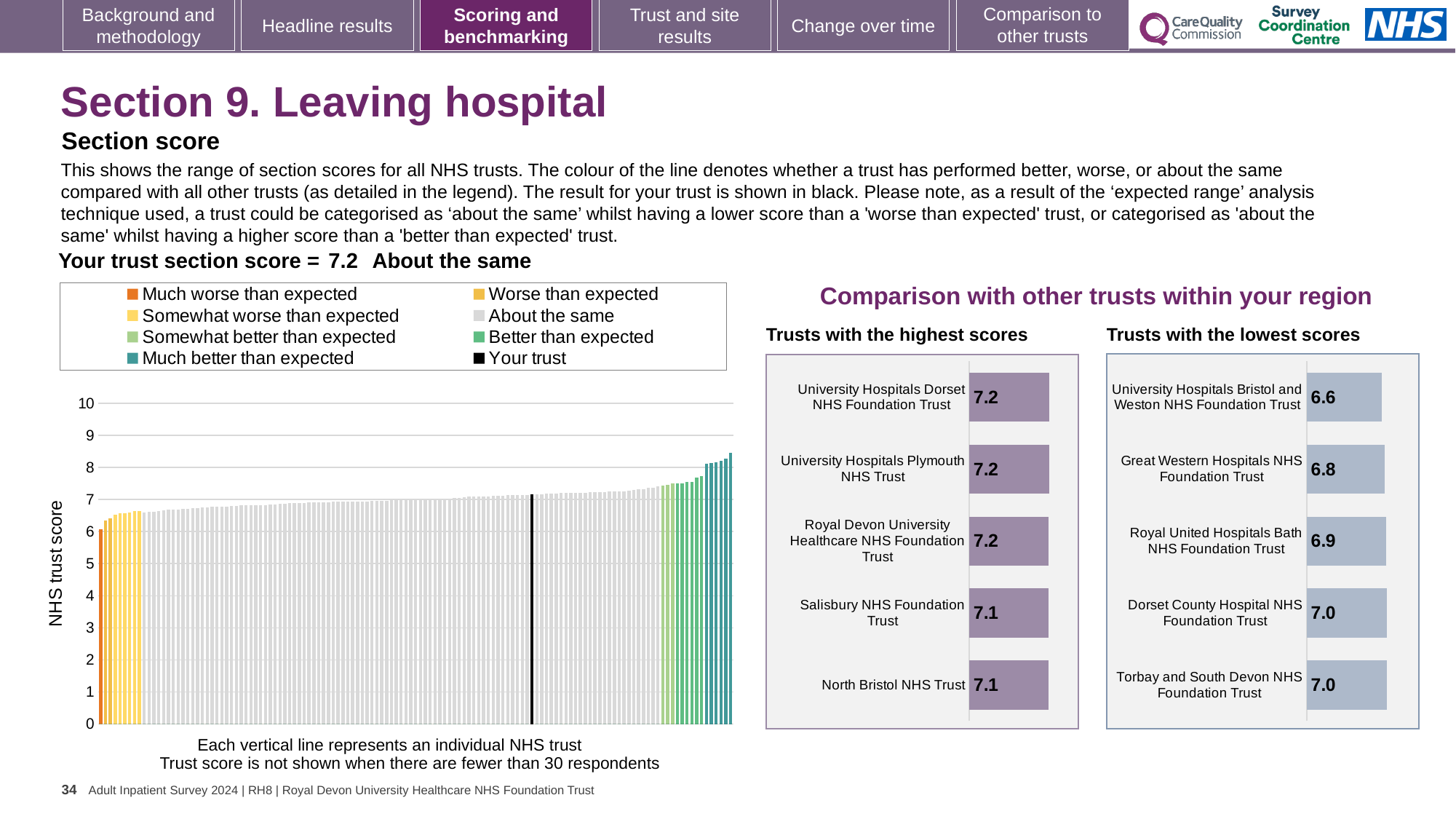
How many trusts are shown in the 'Trusts with the lowest scores' chart? 5 In the 'Trusts with the lowest scores' chart, what is the difference between the scores of Royal United Hospitals Bath NHS Foundation Trust and University Hospitals Bristol and Weston NHS Foundation Trust? 0.3 What is the section score for your trust shown on the slide? 7.2 In the 'Trusts with the lowest scores' chart, which has the higher score: Dorset County Hospital NHS Foundation Trust or Great Western Hospitals NHS Foundation Trust? Dorset County Hospital NHS Foundation Trust How many entries does the legend of the main section score chart list? 8 In the main section score chart, is the value for the lowest-scoring trust greater or less than 5? greater What type of chart is the 'Trusts with the highest scores' chart? Bar chart In the 'Trusts with the lowest scores' chart, what is the score for Great Western Hospitals NHS Foundation Trust? 6.8 In the 'Trusts with the lowest scores' chart, which trust has the lowest score? University Hospitals Bristol and Weston NHS Foundation Trust How many trusts are shown in the 'Trusts with the highest scores' chart? 5 In the 'Trusts with the highest scores' chart, what is the score for Salisbury NHS Foundation Trust? 7.1 What is the label on the vertical axis of the main section score chart? NHS trust score